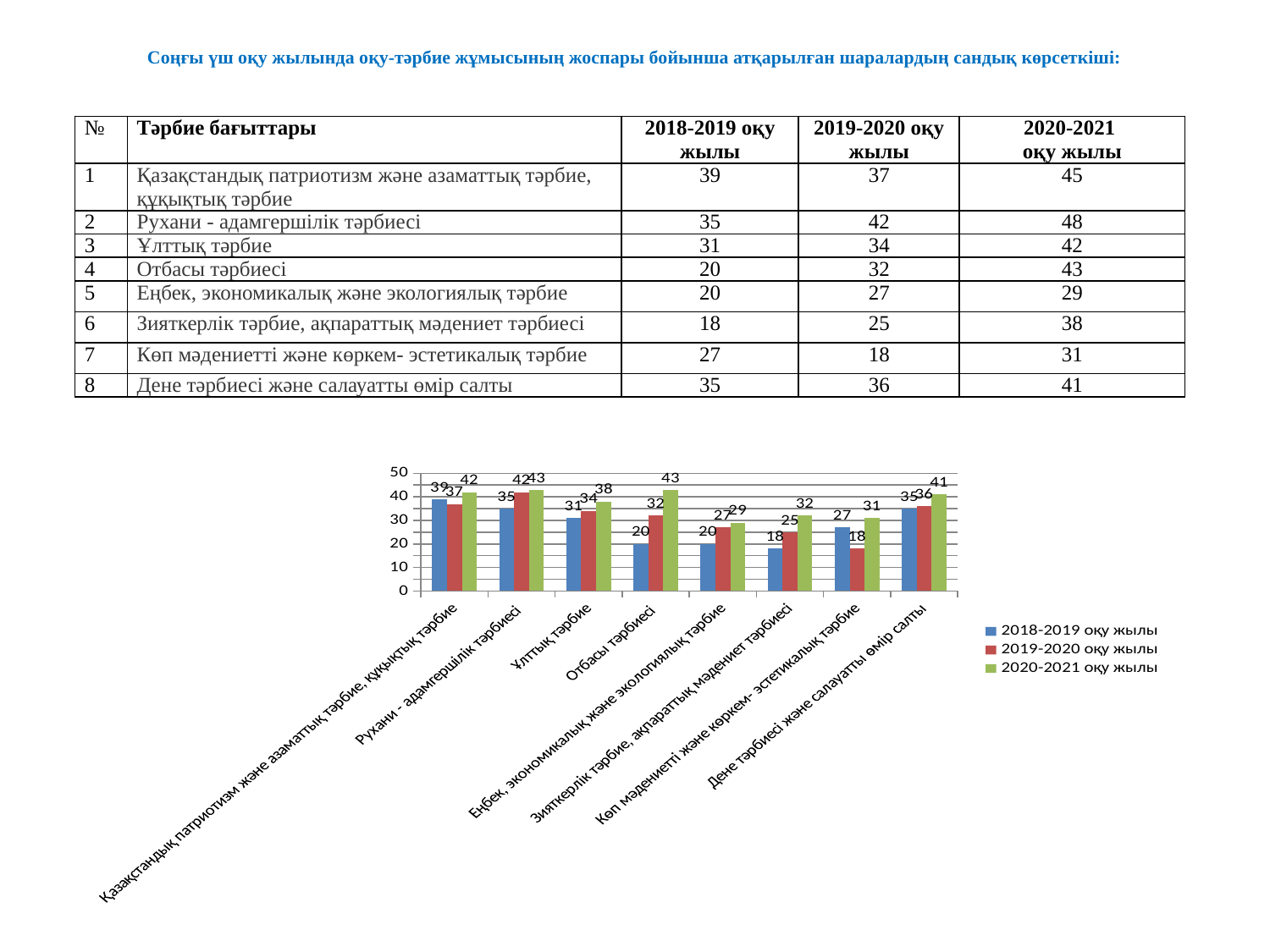
What is the value for Көп мәдениетті және көркем- эстетикалық тәрбие in the 2019-2020 оқу жылы series? 18 For Көп мәдениетті және көркем- эстетикалық тәрбие, which is larger: the 2018-2019 оқу жылы value or the 2019-2020 оқу жылы value? 2018-2019 оқу жылы Do the values for Ұлттық тәрбие rise or fall from 2018-2019 оқу жылы to 2020-2021 оқу жылы? rise What type of chart is shown on the slide? bar chart How many series does the chart legend list? 3 How many categories are plotted along the x axis of the chart? 8 What is the value for Зияткерлік тәрбие, ақпараттық мәдениет тәрбиесі in the 2018-2019 оқу жылы series? 18 Which category has the lowest value in the 2018-2019 оқу жылы series? Зияткерлік тәрбие, ақпараттық мәдениет тәрбиесі What is the difference between the 2020-2021 оқу жылы and 2018-2019 оқу жылы values for Отбасы тәрбиесі? 23 What colour are the bars for the 2020-2021 оқу жылы series? green What is the value for Отбасы тәрбиесі in the 2020-2021 оқу жылы series? 43